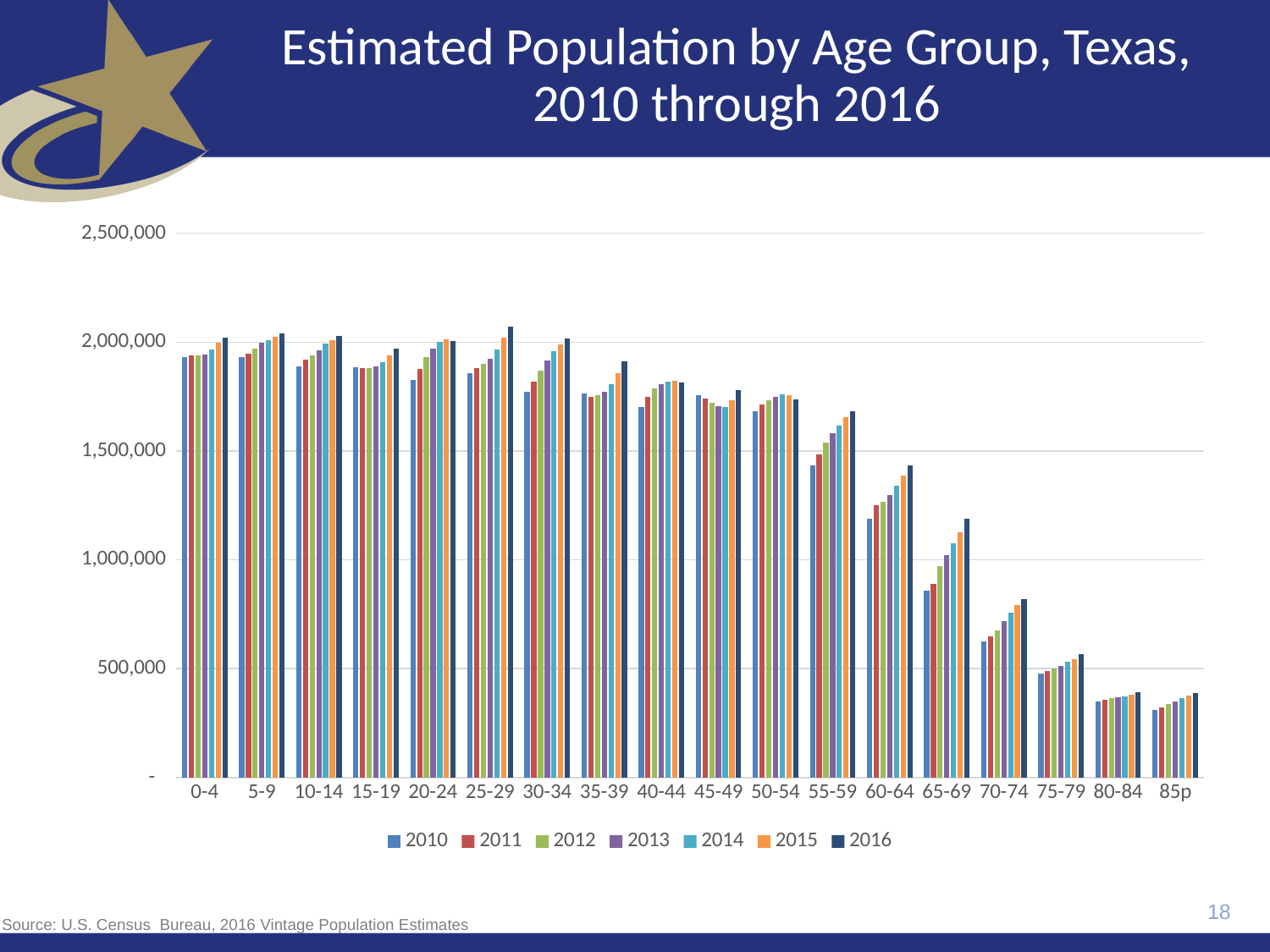
How many age groups are shown on the x axis? 18 Is the 2016 value for the 25-29 age group greater or less than 2,000,000? greater What is the title of the chart? Estimated Population by Age Group, Texas, 2010 through 2016 Is the 2010 value for the 65-69 age group greater or less than 1,000,000? less Is the 2016 value for the 85p age group greater or less than 500,000? less Which years are listed in the legend? 2010, 2011, 2012, 2013, 2014, 2015, 2016 Which is larger: the 2016 value for 60-64 or the 2016 value for 65-69? 60-64 What kind of chart is shown on the slide? Bar chart Within the 65-69 age group, do the values rise or fall from 2010 to 2016? rise How many series does the legend list? 7 Within the 60-64 age group, which year has the lowest value? 2010